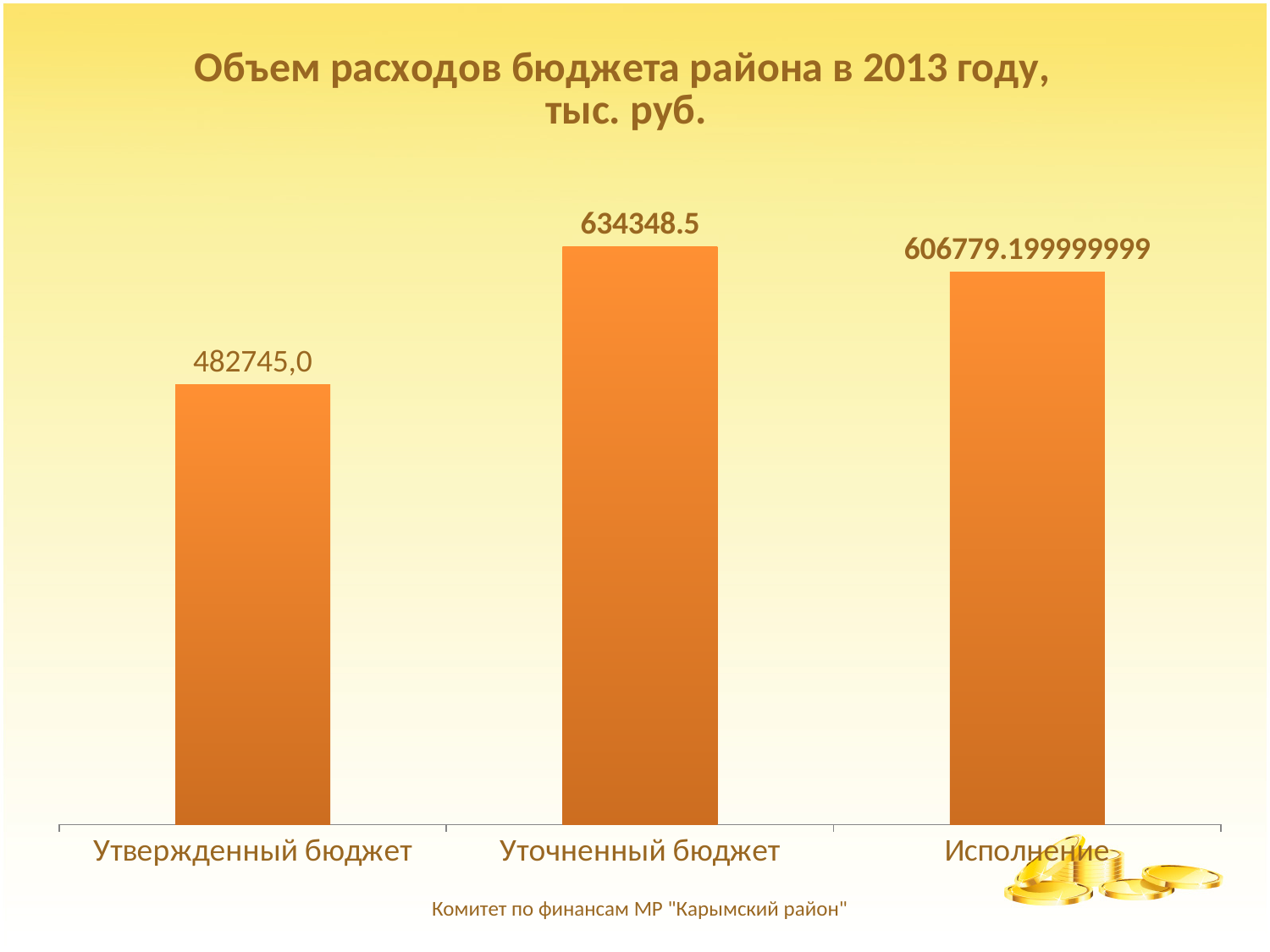
Which is larger, the value for Исполнение or the value for Утвержденный бюджет? Исполнение Which category has the highest value? Уточненный бюджет Which category has the lowest value? Утвержденный бюджет What is the difference between the values for Уточненный бюджет and Утвержденный бюджет? 151603.5 What kind of chart is shown on the slide? Bar chart What colour are the bars in the chart? Orange What is the value for Исполнение? 606779.199999999 What is the value for Утвержденный бюджет? 482745,0 What is the title of the chart? Объем расходов бюджета района в 2013 году, тыс. руб. What is the value for Уточненный бюджет? 634348.5 How many categories are shown in the chart? 3 Which is larger, the value for Уточненный бюджет or the value for Исполнение? Уточненный бюджет